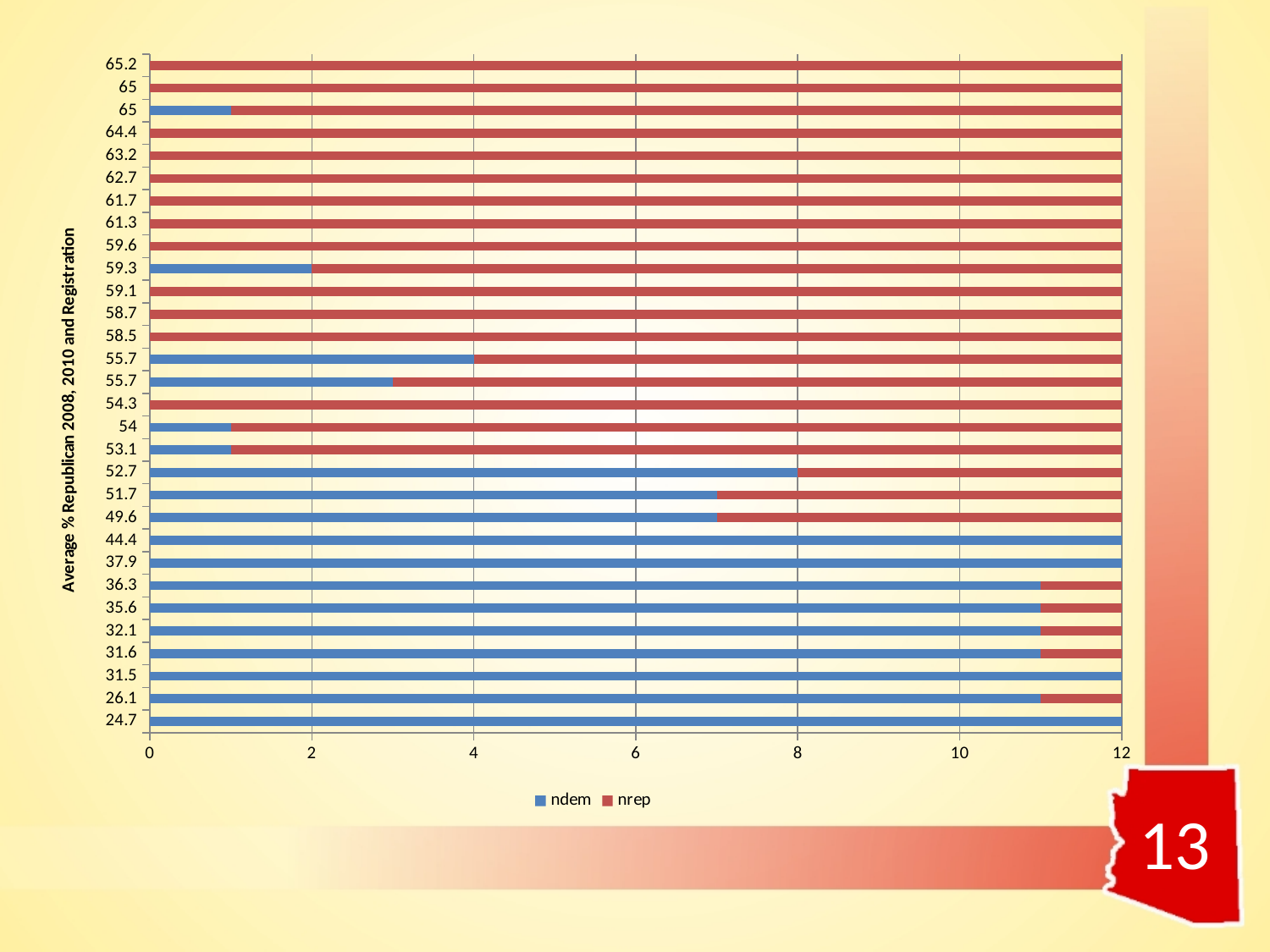
What are the two series named in the legend? ndem and nrep What is the ndem value for the category labelled 52.7? 8 Is the ndem value for the category labelled 51.7 greater or less than 6? greater How many categories are plotted on the vertical axis? 30 Is the nrep value for the category labelled 36.3 greater or less than 2? less What is the title of the vertical axis? Average % Republican 2008, 2010 and Registration What is the ndem value for the category labelled 44.4? 12 What kind of chart is shown on the slide? bar chart What is the ndem value for the category labelled 59.3? 2 What is the nrep value for the category labelled 65.2? 12 How many series does the legend list? 2 Which has the larger ndem value: the category labelled 52.7 or the category labelled 53.1? 52.7